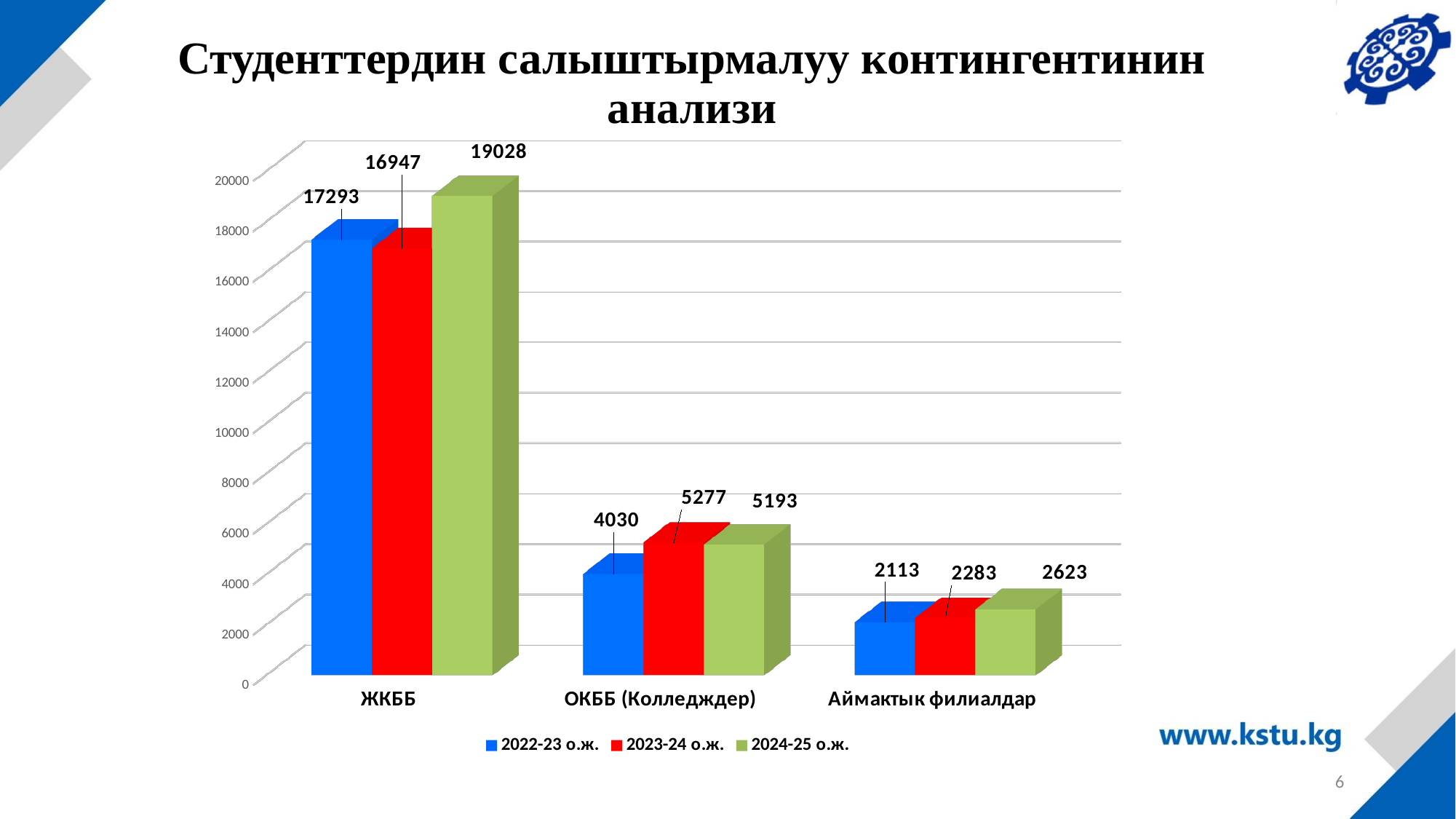
How many series does the legend list? 3 What is the value for ЖКББ in the 2024-25 о.ж. series? 19028 What is the difference between the 2024-25 о.ж. and 2022-23 о.ж. values for ЖКББ? 1735 Which category has the highest value in the 2022-23 о.ж. series? ЖКББ What kind of chart is shown on the slide? Bar chart Which is larger for ОКББ (Колледждер): the 2023-24 о.ж. value or the 2024-25 о.ж. value? 2023-24 о.ж. Which colour represents the 2023-24 о.ж. series in the legend? Red What is the value for ОКББ (Колледждер) in the 2022-23 о.ж. series? 4030 What is the value for Аймактык филиалдар in the 2023-24 о.ж. series? 2283 Do the values for Аймактык филиалдар rise or fall from 2022-23 о.ж. to 2024-25 о.ж.? Rise How many categories are shown on the x axis? 3 Which category has the lowest value in the 2024-25 о.ж. series? Аймактык филиалдар